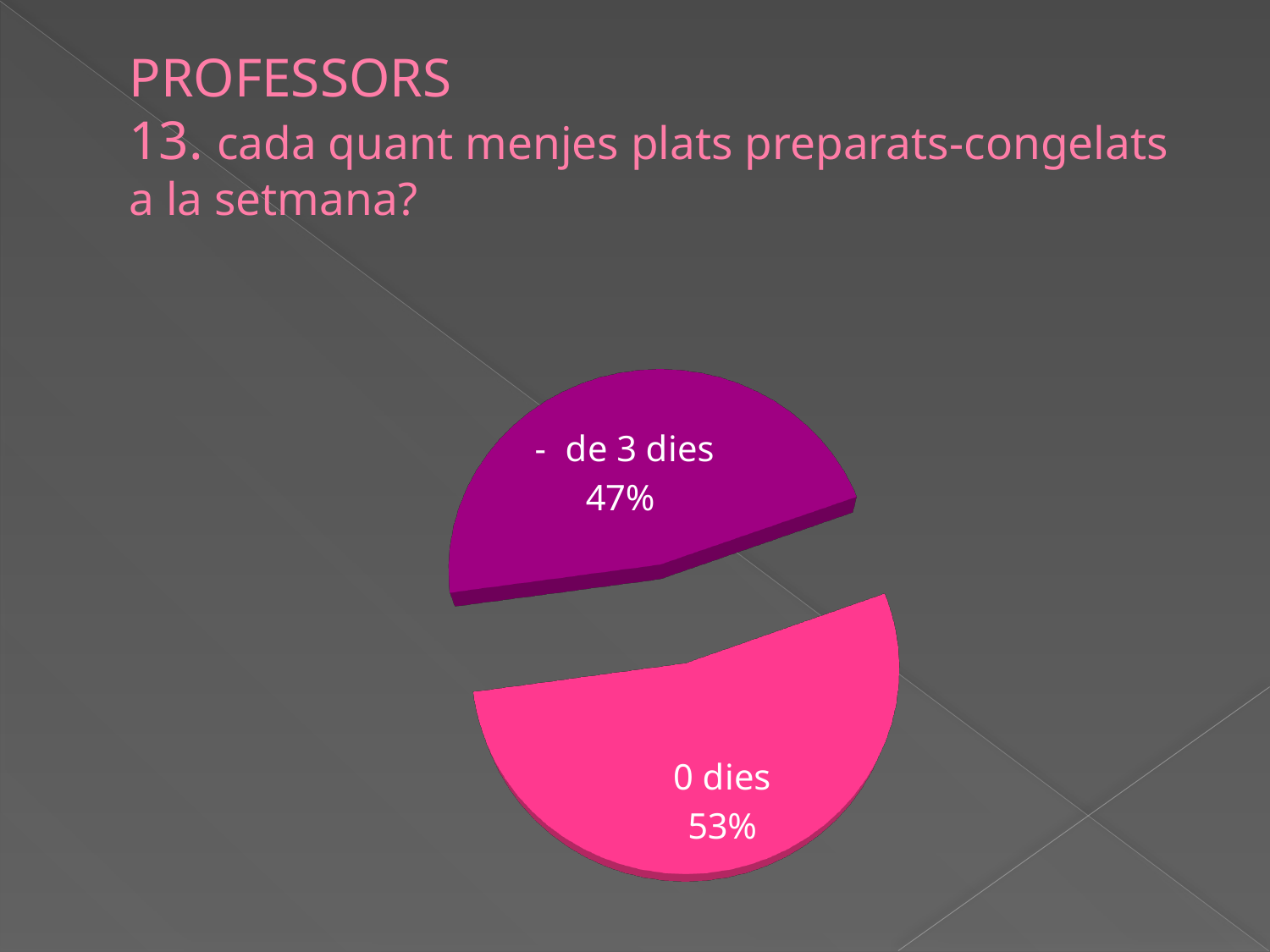
What is the difference in percentage points between the "0 dies" slice and the "- de 3 dies" slice? 6 Which slice of the pie is the largest? 0 dies Which slice of the pie is the smallest? - de 3 dies Is the share for "- de 3 dies" greater or less than 50%? less What kind of chart is shown on the slide? pie chart How many slices does the pie chart have? 2 What percentage of the pie is labelled "0 dies"? 53% Is the share for "0 dies" greater or less than 50%? greater What colour is the "0 dies" slice? pink What percentage of the pie is labelled "- de 3 dies"? 47% Which is larger, the share for "0 dies" or the share for "- de 3 dies"? 0 dies Which group of respondents does the slide title say the chart is about? PROFESSORS